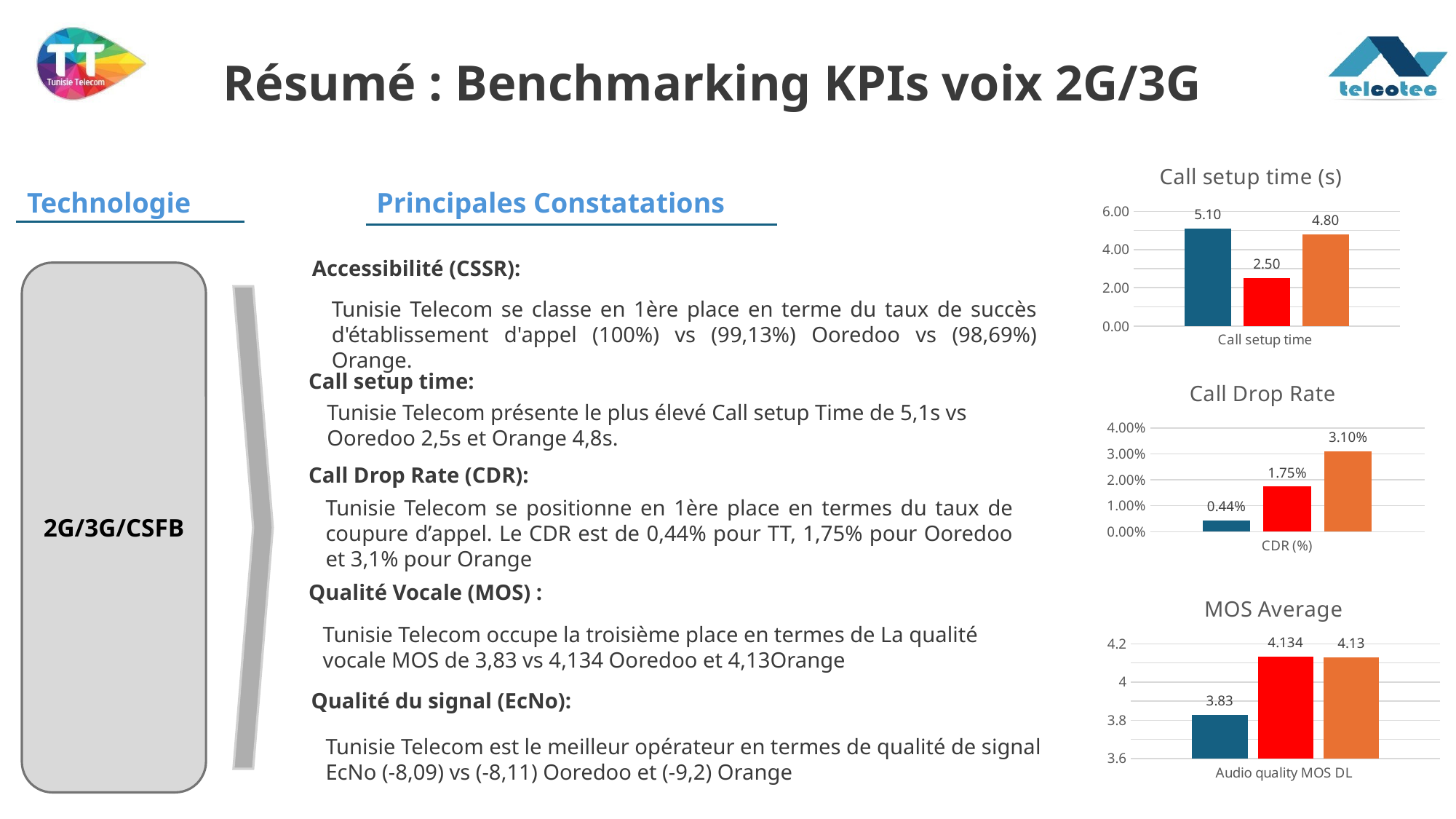
In the Call setup time (s) chart, what is the value of the red bar? 2.50 In the Call Drop Rate chart, what is the value of the orange bar? 3.10% How many bars are shown in the Call Drop Rate chart? 3 In the Call Drop Rate chart, what is the difference between the orange bar and the red bar? 1.35% In the Call setup time (s) chart, what is the difference between the blue bar and the red bar? 2.60 In the Call setup time (s) chart, what is the value of the first (blue) bar? 5.10 What type of chart is the MOS Average chart? Bar chart In the Call setup time (s) chart, is the value of the orange bar greater or less than 4.00? greater In the MOS Average chart, what is the value of the blue bar? 3.83 In the MOS Average chart, which is larger, the blue bar or the red bar? The red bar (4.134) In the Call Drop Rate chart, which bar has the lowest value? The first (blue) bar, 0.44% In the Call setup time (s) chart, which bar is the highest? The first (blue) bar, 5.10